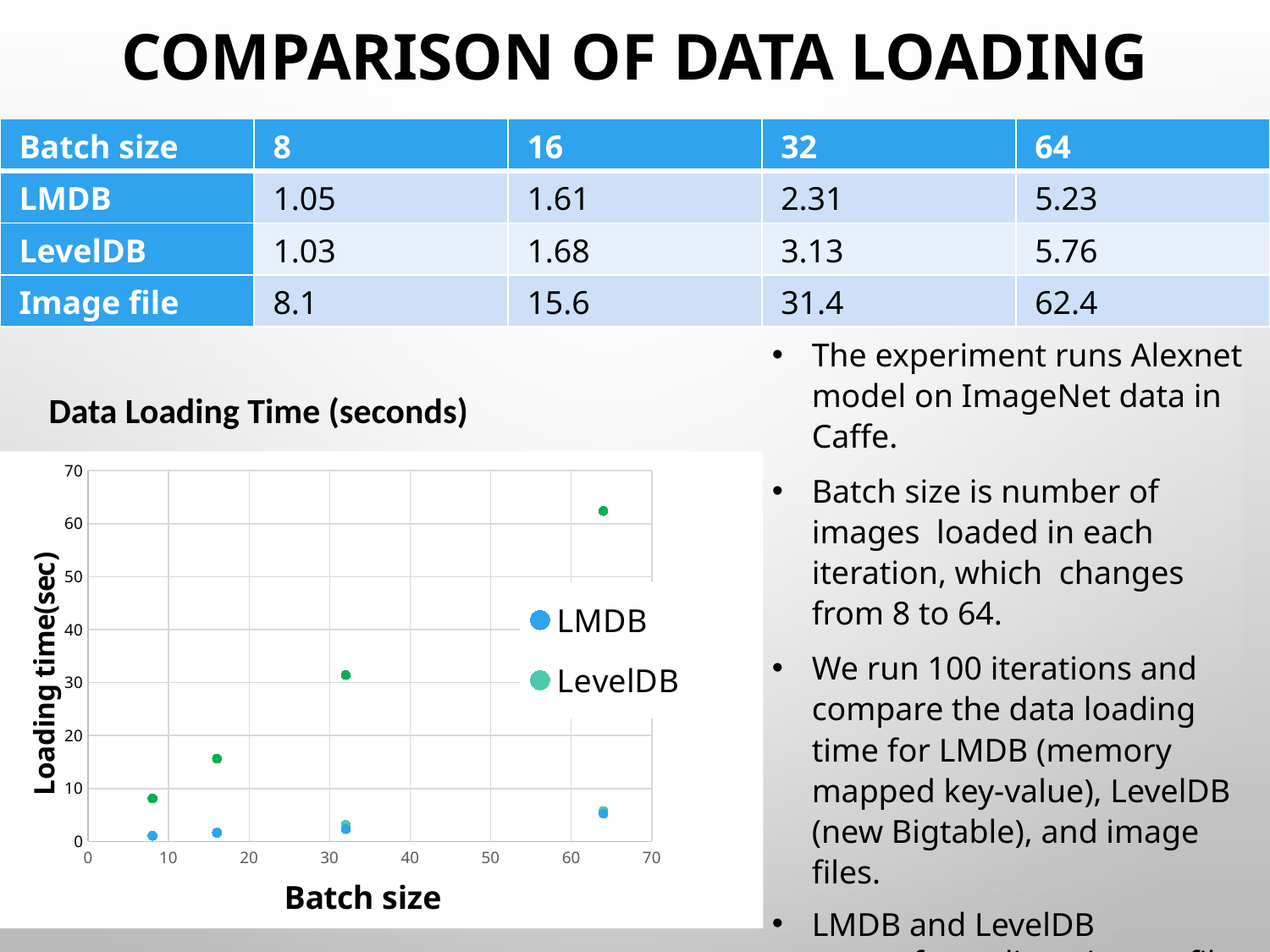
What is the label of the chart's y axis? Loading time(sec) Is the highest plotted point at batch size 16 greater or less than 10 seconds? greater At which batch size does the chart show its highest loading time? 64 Is the LMDB loading time at batch size 64 greater or less than 10 seconds? less What kind of chart is shown on the slide? scatter chart What is the title of the chart? Data Loading Time (seconds) What is the Image file loading time at batch size 64? 62.4 How many distinct batch sizes are plotted on the x axis of the chart? 4 What is the LMDB loading time at batch size 64? 5.23 Do the loading times rise or fall as batch size increases along the x axis? rise Is the highest plotted point at batch size 64 greater or less than 60 seconds? greater How many entries are visible in the chart's legend? 2